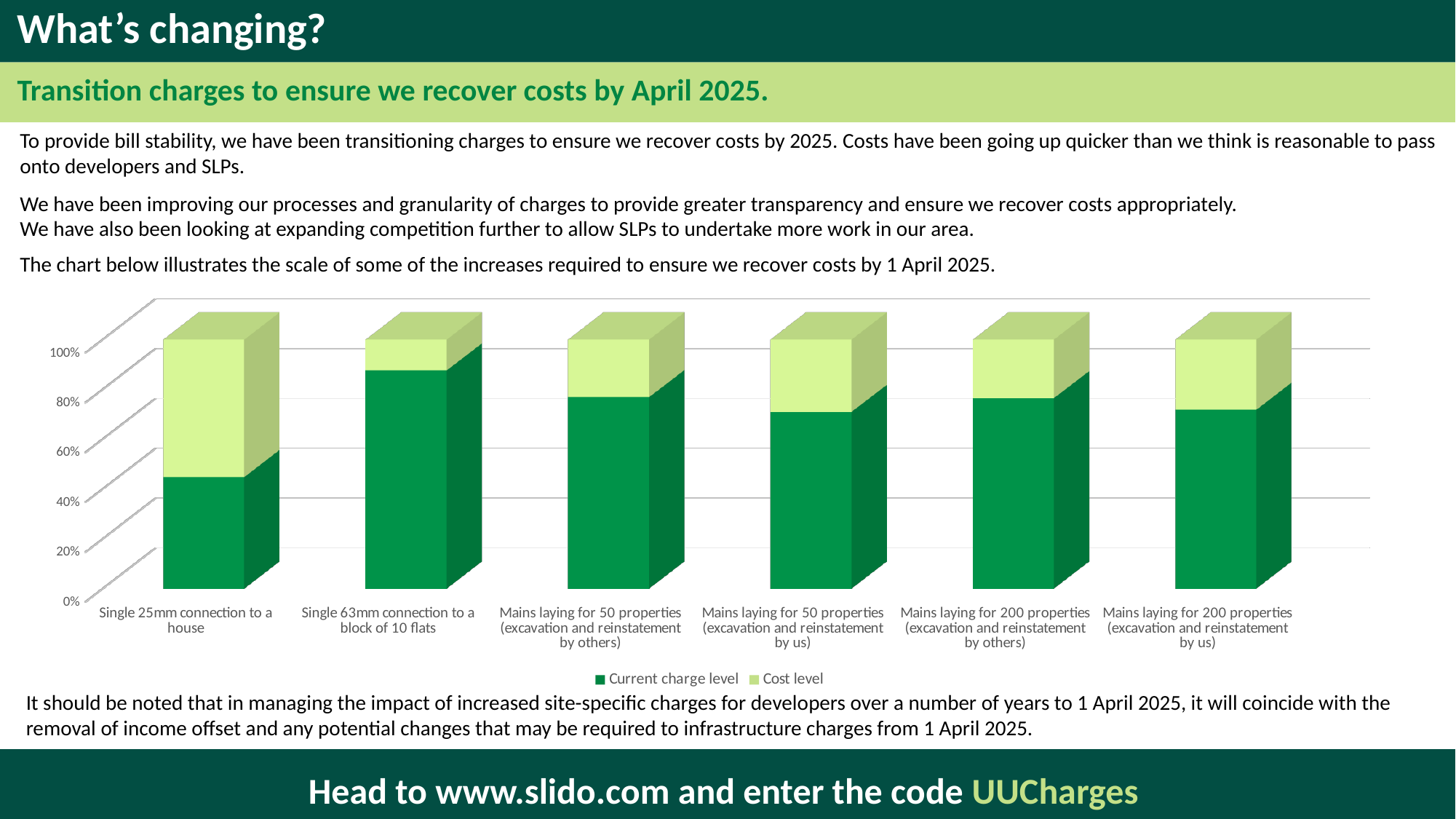
What kind of chart is shown on the slide? Stacked bar chart Which category has the lowest current charge level? Single 25mm connection to a house Which category has the highest current charge level? Single 63mm connection to a block of 10 flats Is the current charge level for Mains laying for 50 properties (excavation and reinstatement by us) greater or less than 80%? less What are the two series named in the chart legend? Current charge level and Cost level Which has the larger current charge level: Single 25mm connection to a house or Single 63mm connection to a block of 10 flats? Single 63mm connection to a block of 10 flats What is the total height of the stacked bar for Single 25mm connection to a house? 100% Is the current charge level for Mains laying for 200 properties (excavation and reinstatement by others) greater or less than 60%? greater How many categories are shown along the x axis of the chart? 6 How many series does the chart legend list? 2 Is the current charge level for Single 63mm connection to a block of 10 flats greater or less than 80%? greater